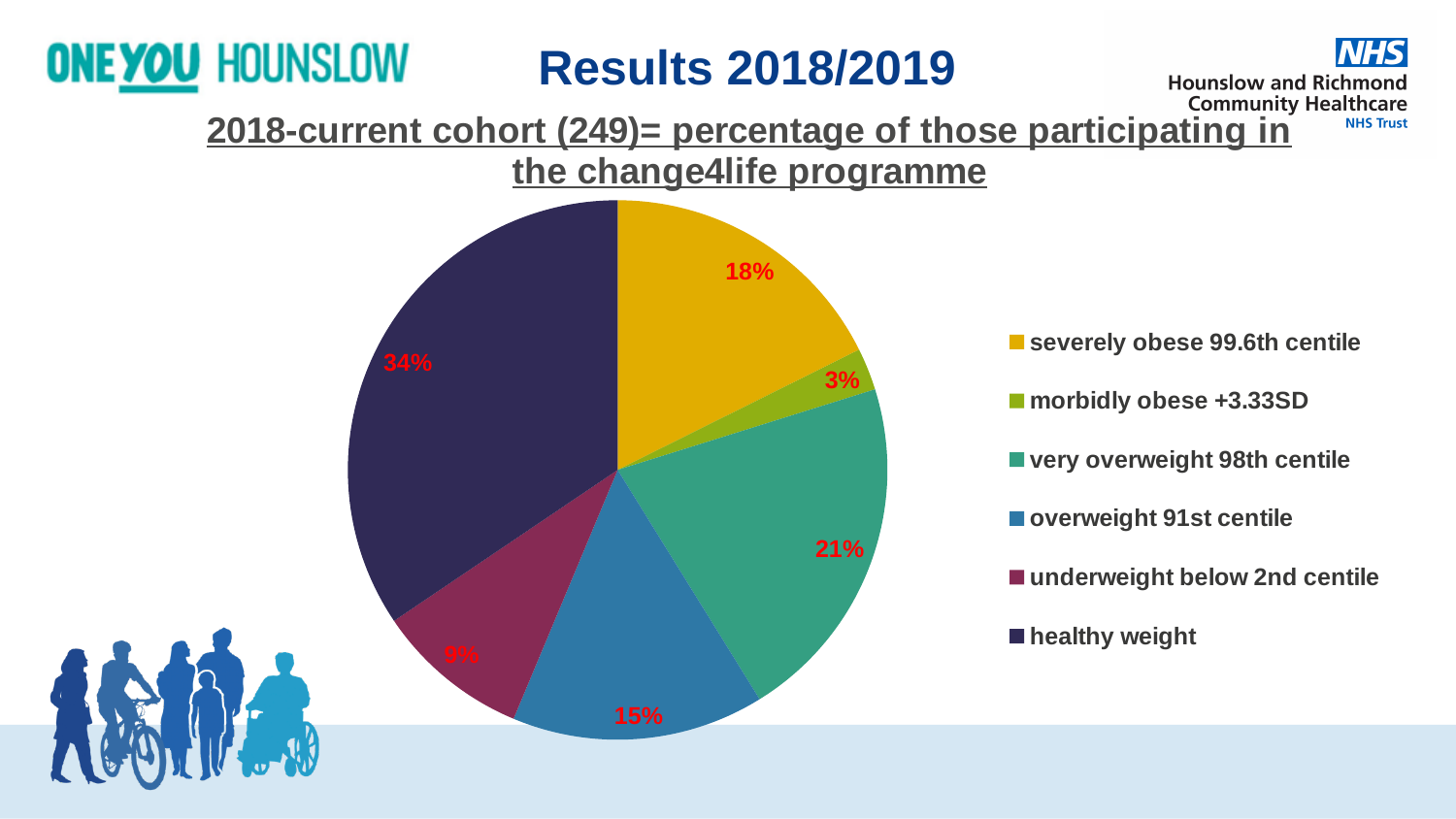
Which category has the largest share of the pie? healthy weight What percentage of the cohort is in the healthy weight category? 34% How many categories does the legend list? 6 What percentage of the cohort is morbidly obese (+3.33SD)? 3% What percentage of the cohort is overweight (91st centile)? 15% Which category has the smallest share of the pie? morbidly obese +3.33SD Which is larger: the severely obese 99.6th centile slice or the overweight 91st centile slice? severely obese 99.6th centile What percentage of the cohort is very overweight (98th centile)? 21% What is the difference in percentage points between the healthy weight slice and the very overweight 98th centile slice? 13 What colour is the healthy weight slice? dark navy/purple What percentage of the cohort is severely obese (99.6th centile)? 18% What kind of chart is shown on the slide? pie chart